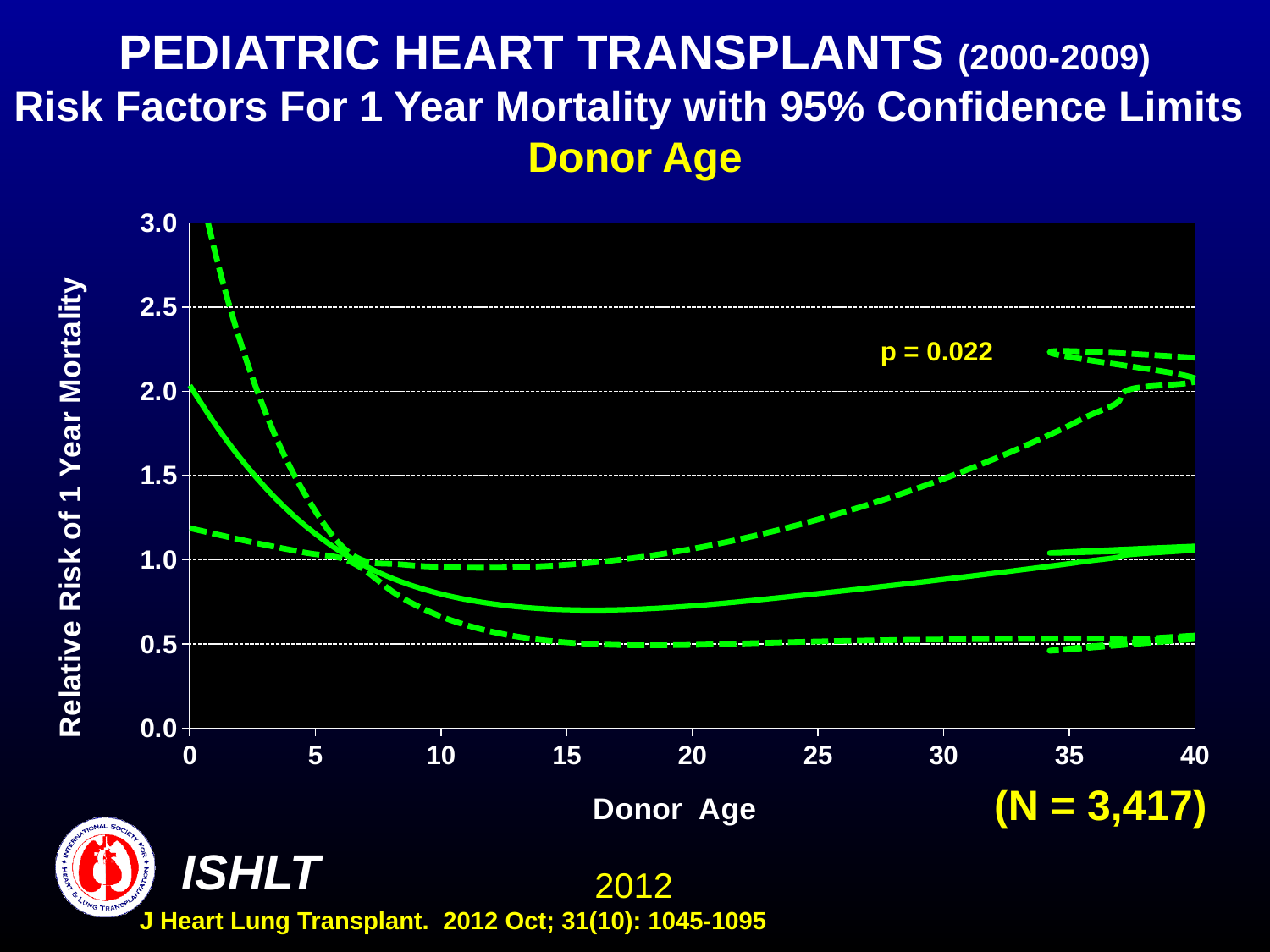
What sample size (N) is printed on the slide? N = 3,417 Is the upper dashed confidence limit at donor age 20 greater or less than 1.5? less Does the solid relative risk line rise or fall as donor age increases from 0 to 10? fall What p-value is printed on the chart? p = 0.022 How many lines are plotted on the chart? 3 Is the relative risk shown by the solid line at donor age 10 greater or less than 1.0? less What kind of chart is shown on the slide? line chart Is the lower dashed confidence limit at donor age 30 greater or less than 1.0? less Does the solid relative risk line rise or fall as donor age increases from 20 to 40? rise Does the upper dashed confidence limit rise or fall as donor age increases from 15 to 35? rise